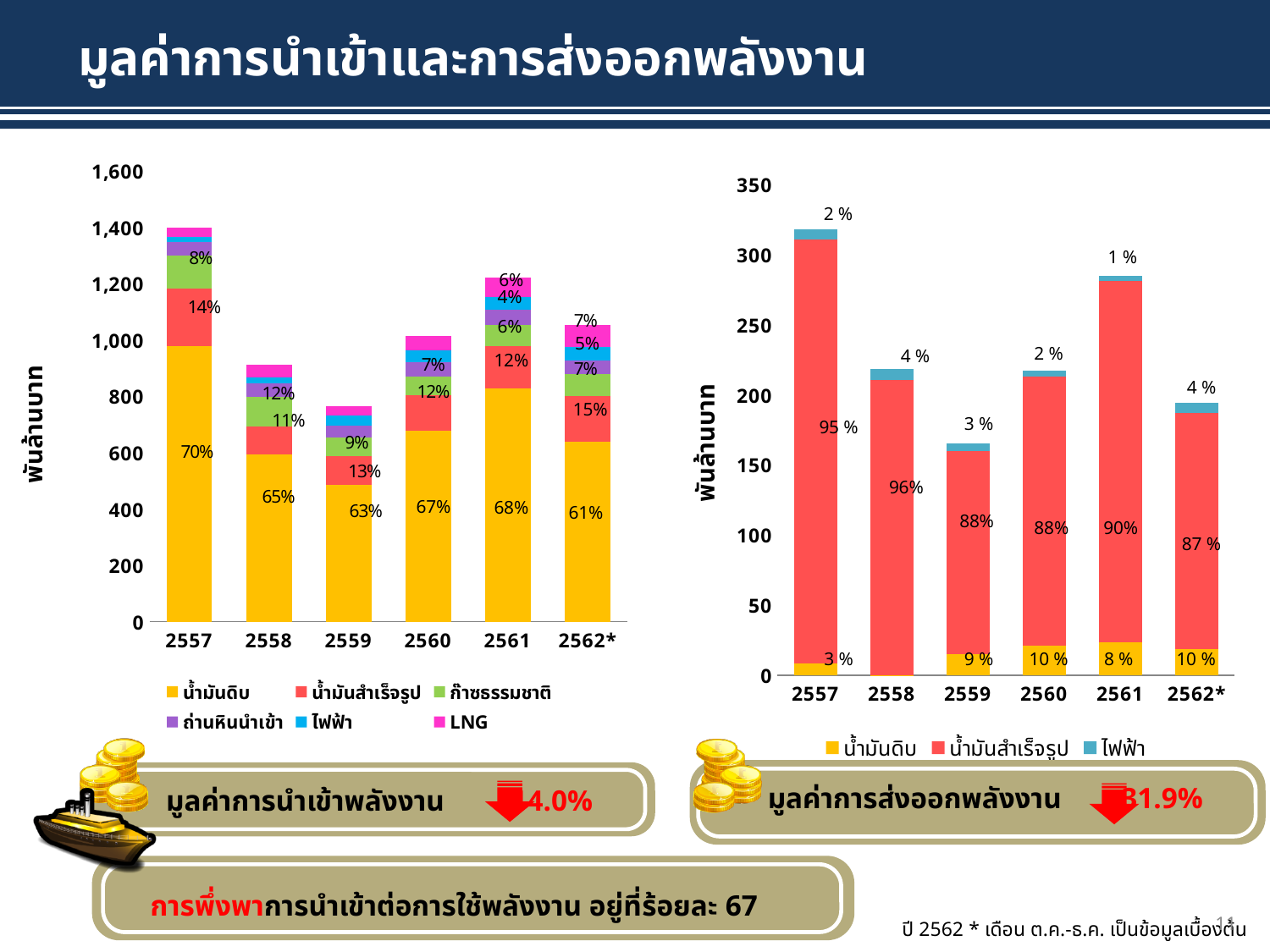
On the right chart (energy export value), which year has the highest total bar? 2557 On the left chart (energy import value), which year has the highest total bar? 2557 On the right chart (energy export value), is the total bar for 2559 greater or less than 200? less On the left chart (energy import value), which year has the lowest total bar? 2559 On the left chart (energy import value), how many series does the legend list? 6 On the right chart (energy export value), how many series does the legend list? 3 On the right chart (energy export value), what percentage share does ไฟฟ้า have in 2561? 1 % On the right chart (energy export value), what percentage share does น้ำมันสำเร็จรูป have in 2558? 96% On the left chart (energy import value), what percentage share does น้ำมันดิบ have in 2562*? 61% On the left chart (energy import value), is the total bar for 2557 greater or less than 1,200? greater What kind of chart is the right chart (energy export value)? bar chart On the left chart (energy import value), what percentage share does น้ำมันดิบ have in 2557? 70%